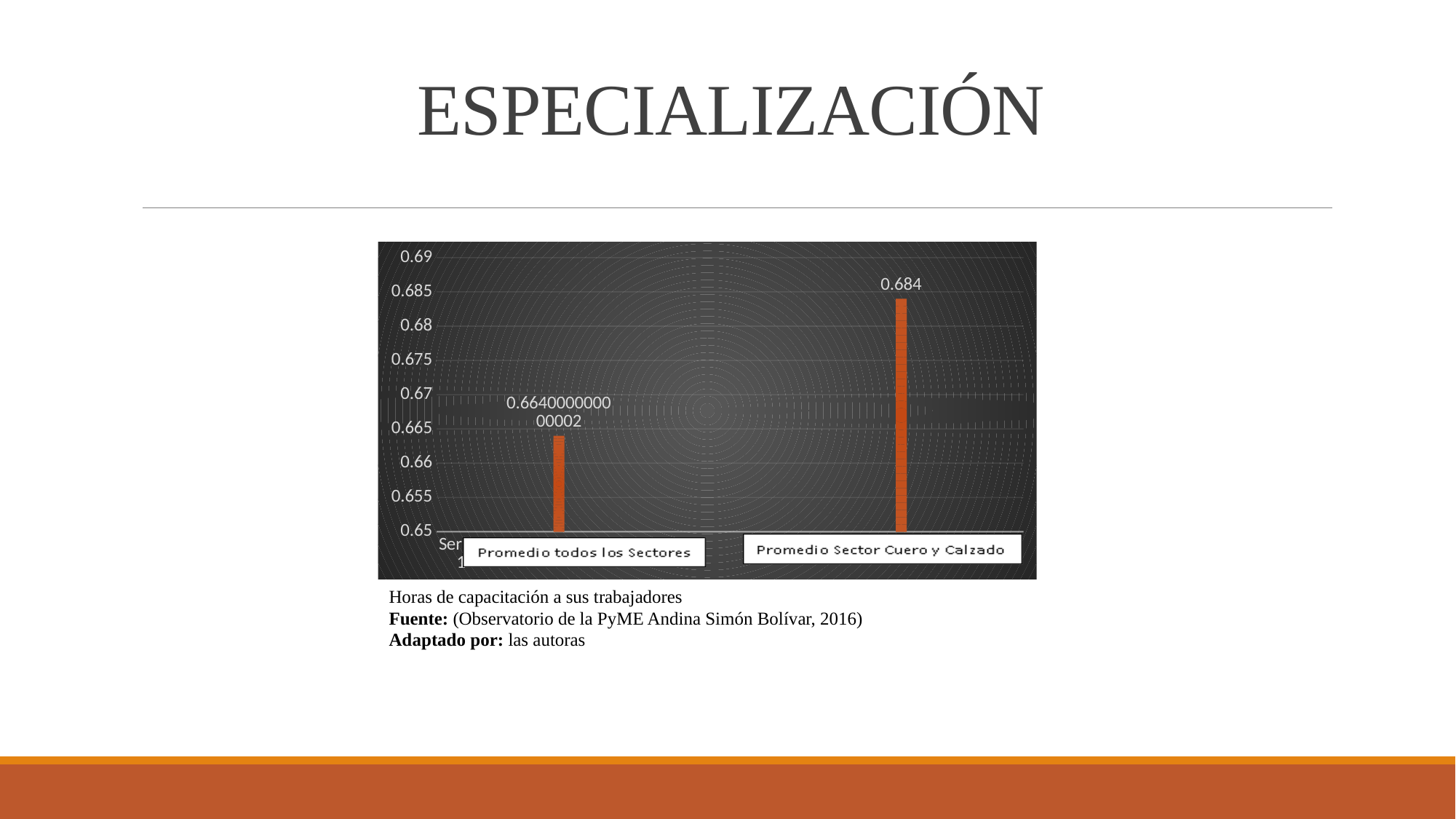
Which category has the lowest value? Promedio todos los Sectores How many bars (categories) does the chart show? 2 Is the value for Promedio Sector Cuero y Calzado greater or less than 0.68? greater Which is larger, the value for Promedio todos los Sectores or the value for Promedio Sector Cuero y Calzado? Promedio Sector Cuero y Calzado What is the highest value shown on the vertical axis of the chart? 0.69 Is the value for Promedio todos los Sectores greater or less than 0.66? greater According to the caption, what does the chart measure? Horas de capacitación a sus trabajadores What kind of chart is shown on the slide? bar chart Is the value for Promedio todos los Sectores greater or less than 0.67? less What is the value for Promedio Sector Cuero y Calzado? 0.684 Which category has the highest value? Promedio Sector Cuero y Calzado